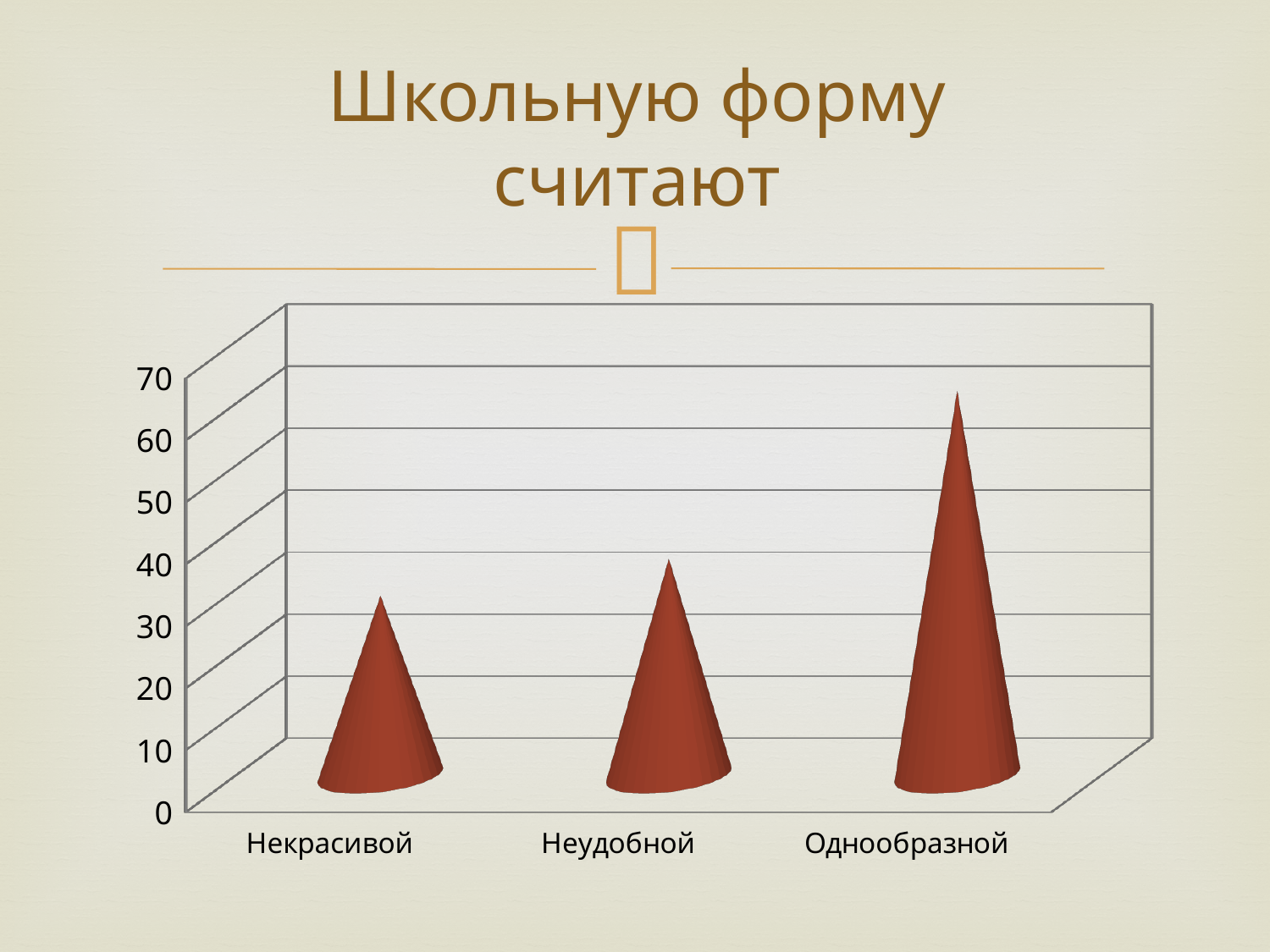
Which category has the lowest value in the chart? Некрасивой Which is larger, the value for Однообразной or the value for Неудобной? Однообразной What is the highest value shown on the vertical axis of the chart? 70 How many categories are shown on the x axis of the chart? 3 What is the title of the slide above the chart? Школьную форму считают Is the value for Некрасивой greater or less than 50? less What kind of chart is shown on the slide? bar chart Which is larger, the value for Неудобной or the value for Некрасивой? Неудобной Is the value for Некрасивой greater or less than 20? greater Is the value for Однообразной greater or less than 50? greater Which category has the highest value in the chart? Однообразной